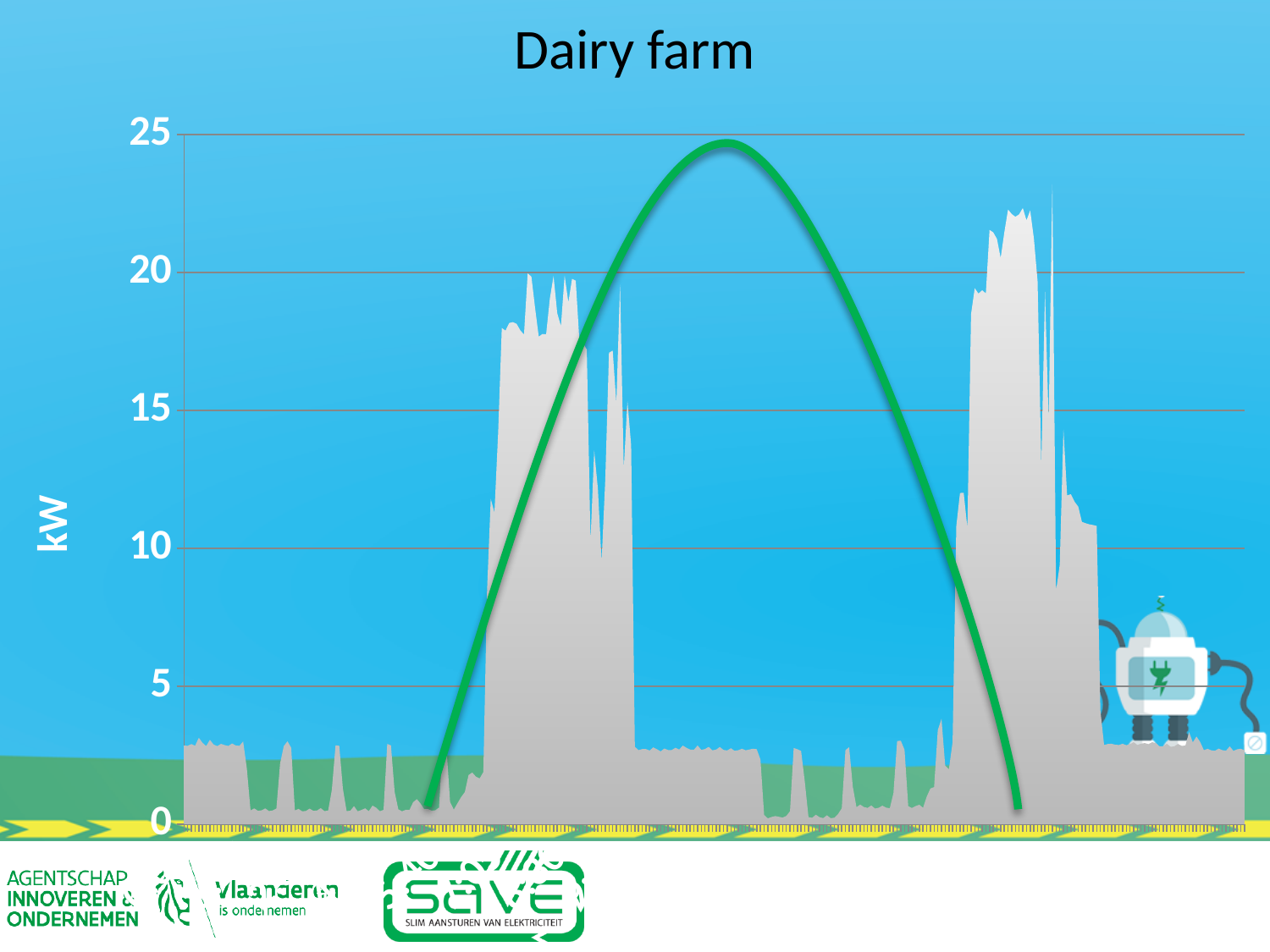
What is the label on the vertical axis of the chart? kW Is the highest point of the grey area greater or less than 20 kW? greater How many data series are plotted on the chart? 1 What kind of chart is shown on the slide? Area chart with a line overlay What is the highest value shown on the vertical axis? 25 How does the green curve behave from left to right across the chart? It rises to a peak and then falls What is the title of the chart? Dairy farm Is the grey area at the far left of the chart greater or less than 5 kW? less Which reaches a higher peak value, the green curve or the grey area? The green curve What is the interval between the tick marks on the vertical axis? 5 Is the peak of the green curve greater or less than 20 kW? greater How many tick labels are shown on the vertical axis? 6